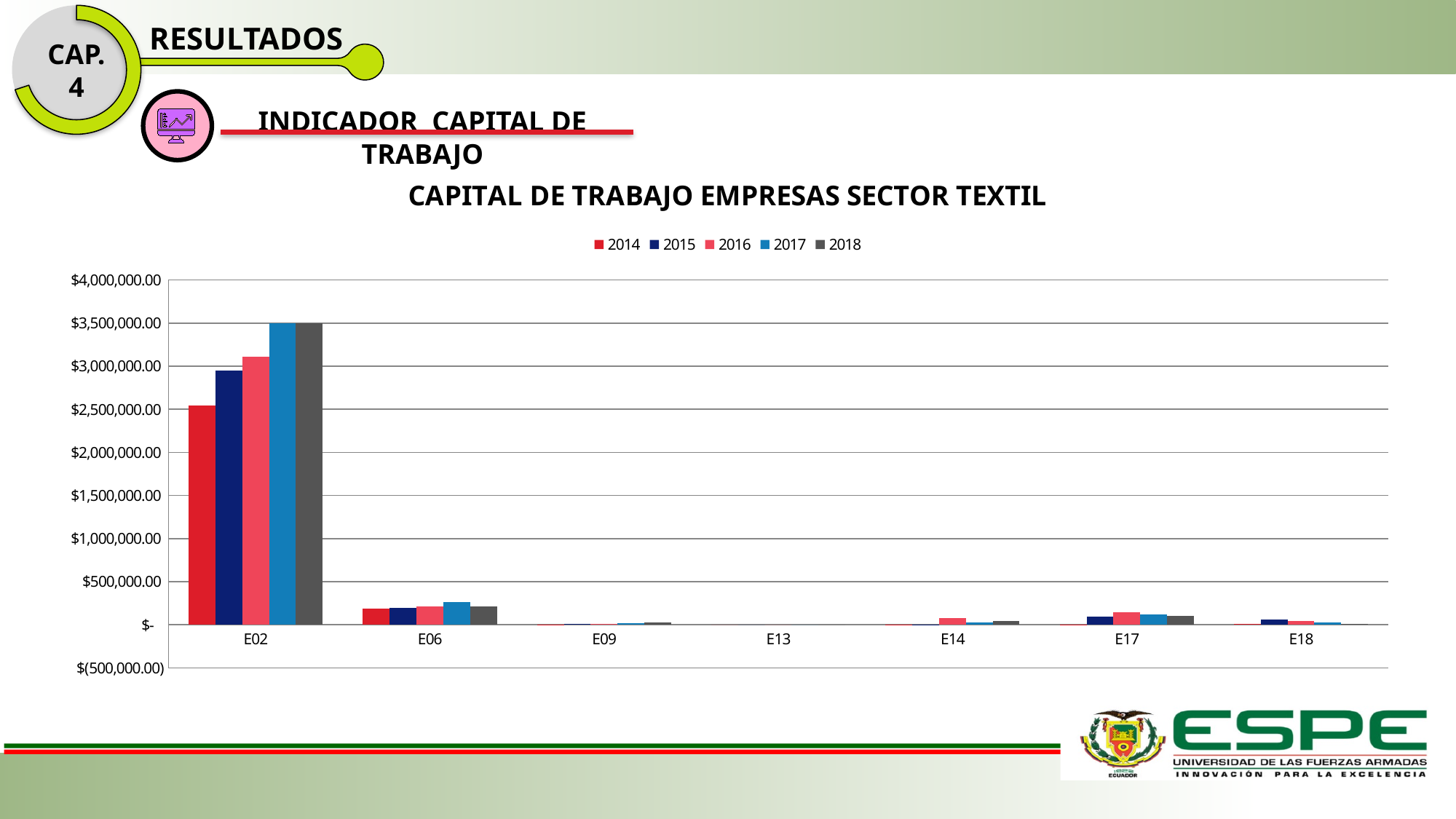
For E02, which is larger: the 2014 value or the 2017 value? 2017 Is the 2017 value for E06 greater or less than $500,000.00? less Do the E02 bars rise or fall from 2014 to 2017? rise What is the title of the chart? CAPITAL DE TRABAJO EMPRESAS SECTOR TEXTIL How many companies (categories) are shown on the x axis of the chart? 7 For the 2017 series, which is larger: E06 or E17? E06 For E02, which year has the lowest value? 2014 Is the 2014 value for E02 greater or less than $2,000,000.00? greater Is the 2017 value for E02 greater or less than $3,000,000.00? greater Which company has the highest working capital values in the chart? E02 What kind of chart is shown on the slide? bar chart How many series does the legend list? 5